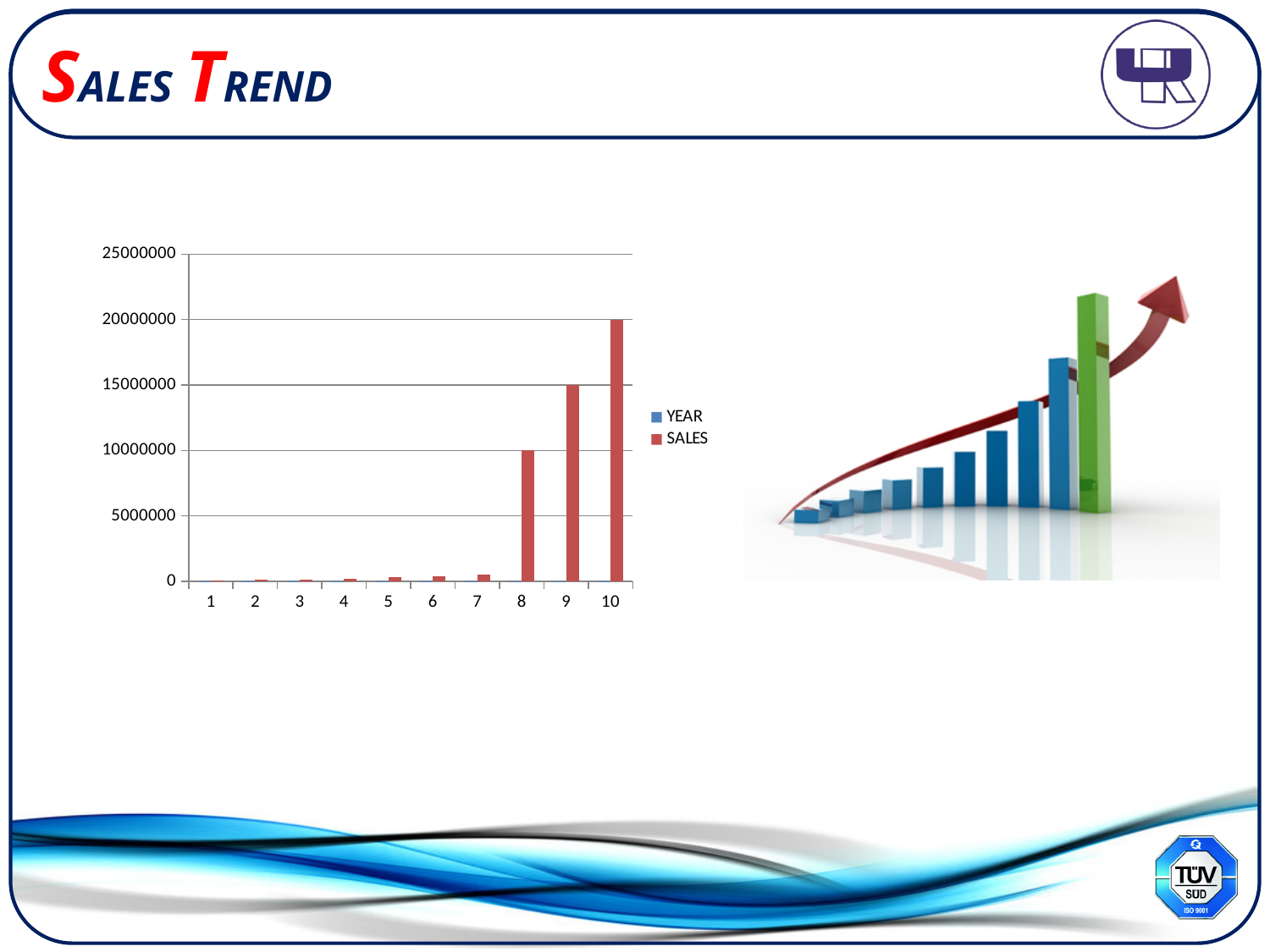
How many categories are shown along the x axis of the chart? 10 Do the SALES values rise or fall from category 1 to category 10? rise What are the two entries listed in the chart legend? YEAR and SALES Is the SALES value for category 7 greater or less than 5000000? less What is the SALES value for category 8? 10000000 What kind of chart is shown on the slide? bar chart What is the SALES value for category 10? 20000000 How many series does the chart legend list? 2 Which category has the highest SALES value? 10 What is the SALES value for category 9? 15000000 What is the difference between the SALES values for category 10 and category 8? 10000000 Which is larger, the SALES value for category 9 or for category 8? category 9